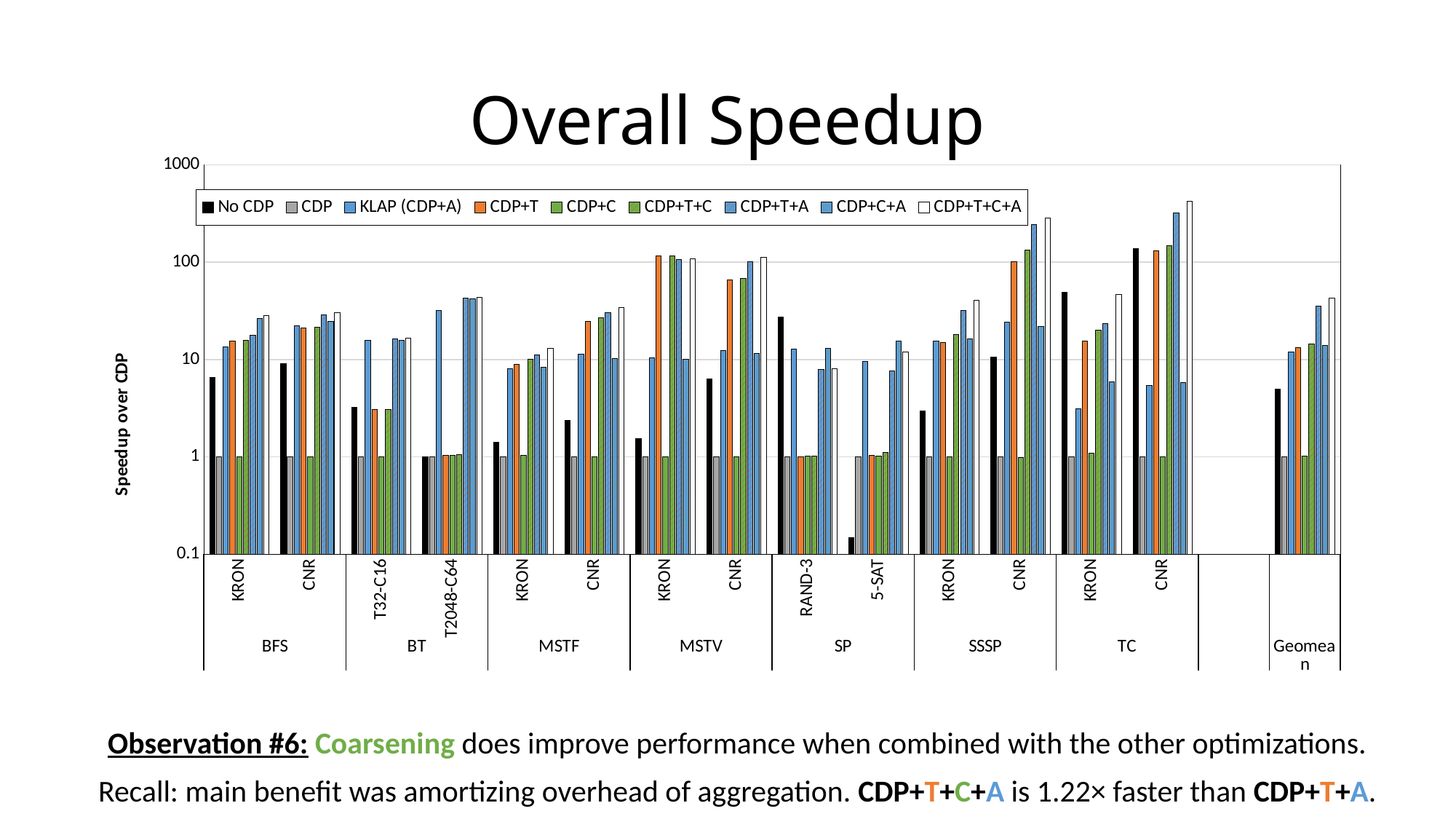
What kind of chart is shown on the slide? bar chart What is the label on the y axis? Speedup over CDP Is the value for CDP+T in the BT T32-C16 group greater or less than 10? less Is the value for No CDP in the TC KRON group greater or less than 100? less How many series does the legend list? 9 Is the value for No CDP in the SP 5-SAT group greater or less than 1? less How many benchmark groups (including Geomean) are labeled along the x axis? 8 In the TC CNR group, which is larger: CDP+T+C+A or CDP+C+A? CDP+T+C+A In the Geomean group, which is larger: No CDP or CDP+T+C+A? CDP+T+C+A What is the title of the chart? Overall Speedup What is the value for CDP in the BFS KRON group? 1